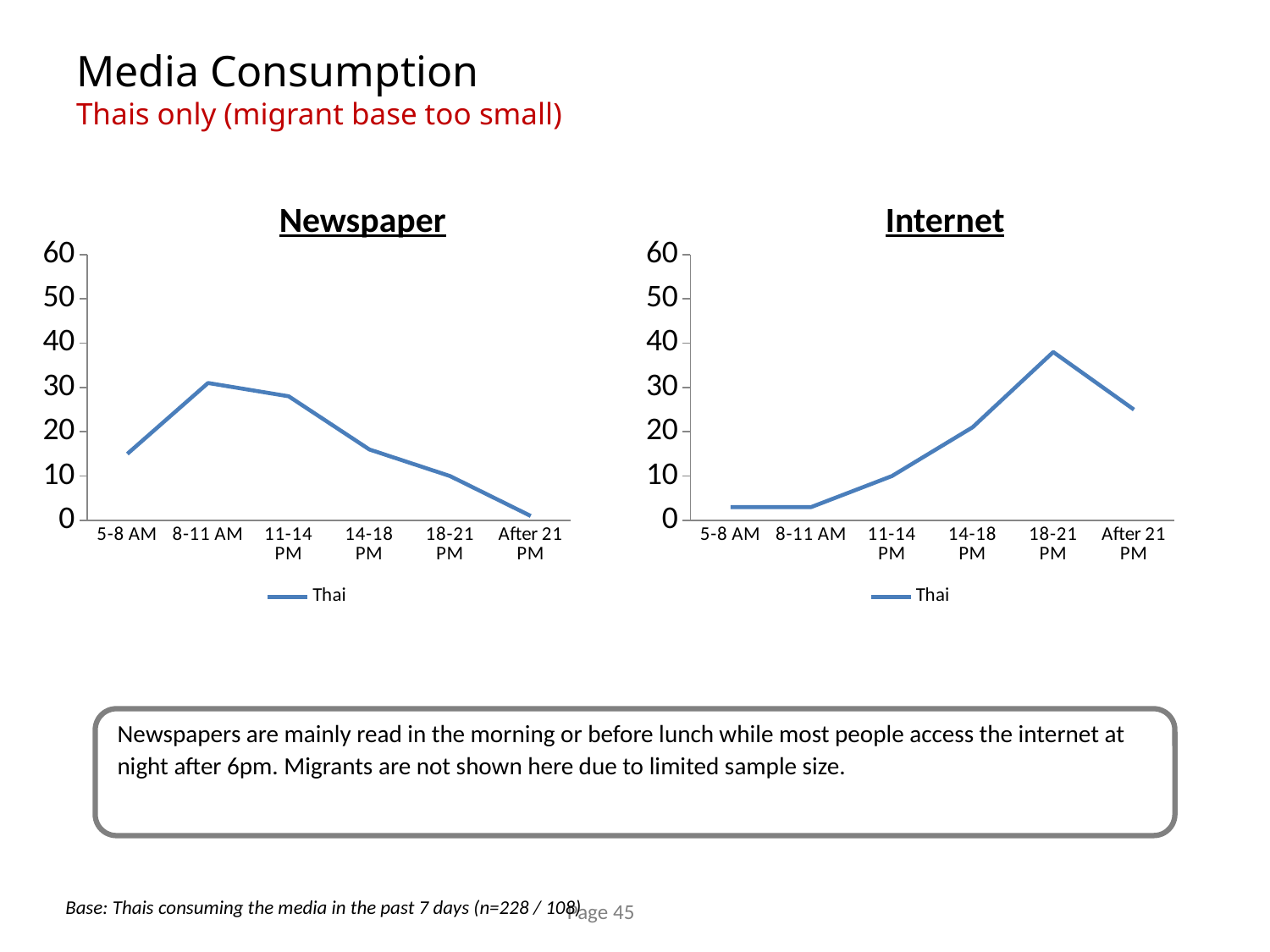
How many series does the legend of the Newspaper chart list? 1 In the Newspaper chart, is the value for 5-8 AM greater or less than 20? less In the Newspaper chart, which time slot has the lowest value? After 21 PM In the Newspaper chart, which time slot has the highest value? 8-11 AM In the Newspaper chart, which is larger, the value for 8-11 AM or the value for 18-21 PM? 8-11 AM In the Internet chart, is the value for 18-21 PM greater or less than 30? greater In the Internet chart, is the value for 5-8 AM greater or less than 10? less In the Internet chart, which is larger, the value for 14-18 PM or the value for 11-14 PM? 14-18 PM What kind of chart is the Newspaper chart? line chart How many time slots are shown on the x axis of the Internet chart? 6 In the Internet chart, which time slot has the highest value? 18-21 PM